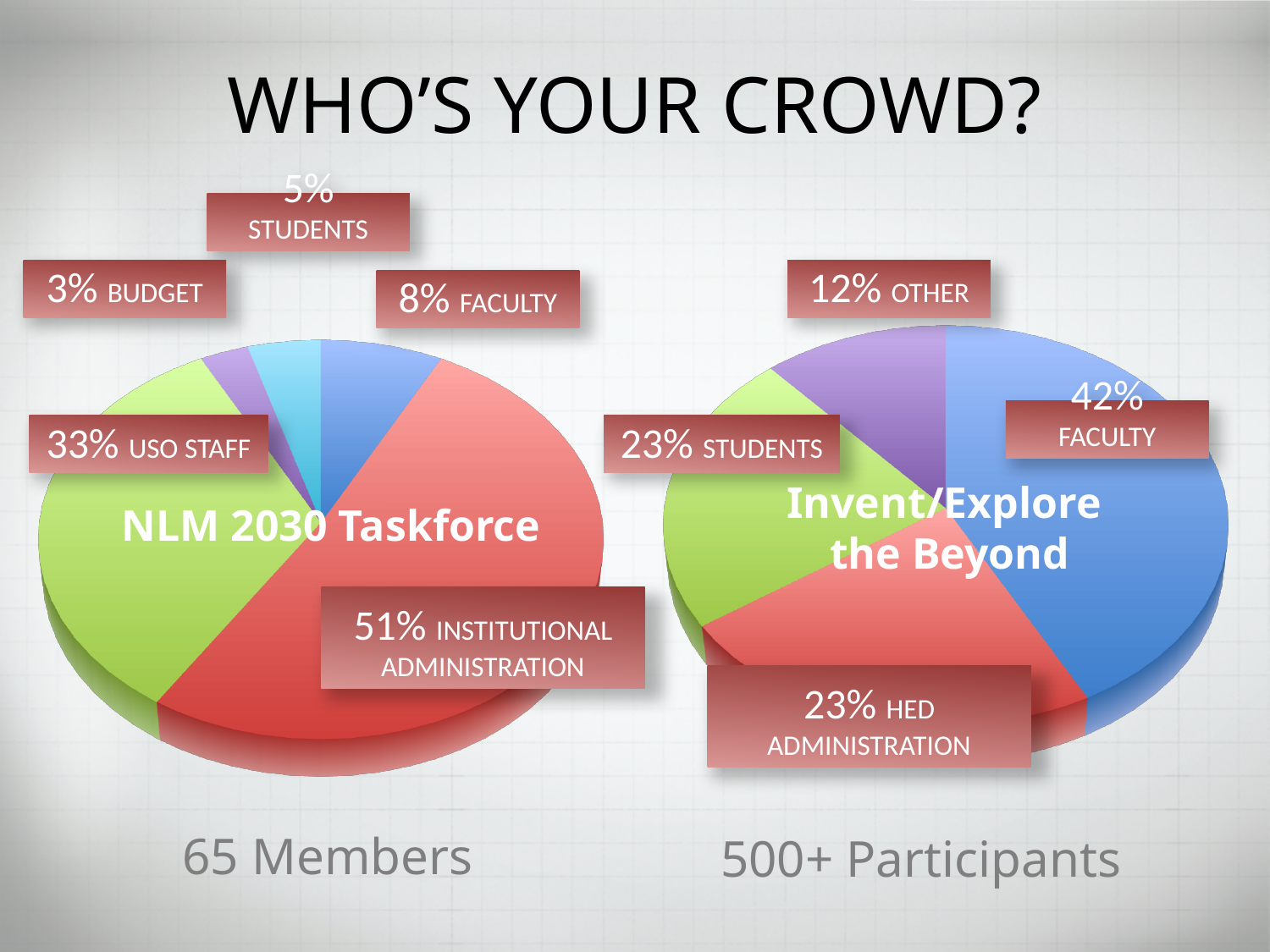
In the Invent/Explore the Beyond pie chart, what share is Faculty? 42% What kind of charts are shown on the slide? Pie charts In the NLM 2030 Taskforce pie chart, what is the difference between the Faculty share and the Students share? 3% In the NLM 2030 Taskforce pie chart, what share is USO Staff? 33% In the Invent/Explore the Beyond pie chart, which category has the largest share? Faculty In the Invent/Explore the Beyond pie chart, what share is Other? 12% Which is larger in the Invent/Explore the Beyond pie chart: the Faculty share or the HED Administration share? Faculty In the NLM 2030 Taskforce pie chart, which category has the largest share? Institutional Administration In the NLM 2030 Taskforce pie chart, which category has the smallest share? Budget In the Invent/Explore the Beyond pie chart, how many slices are there? 4 In the NLM 2030 Taskforce pie chart, how many slices are there? 5